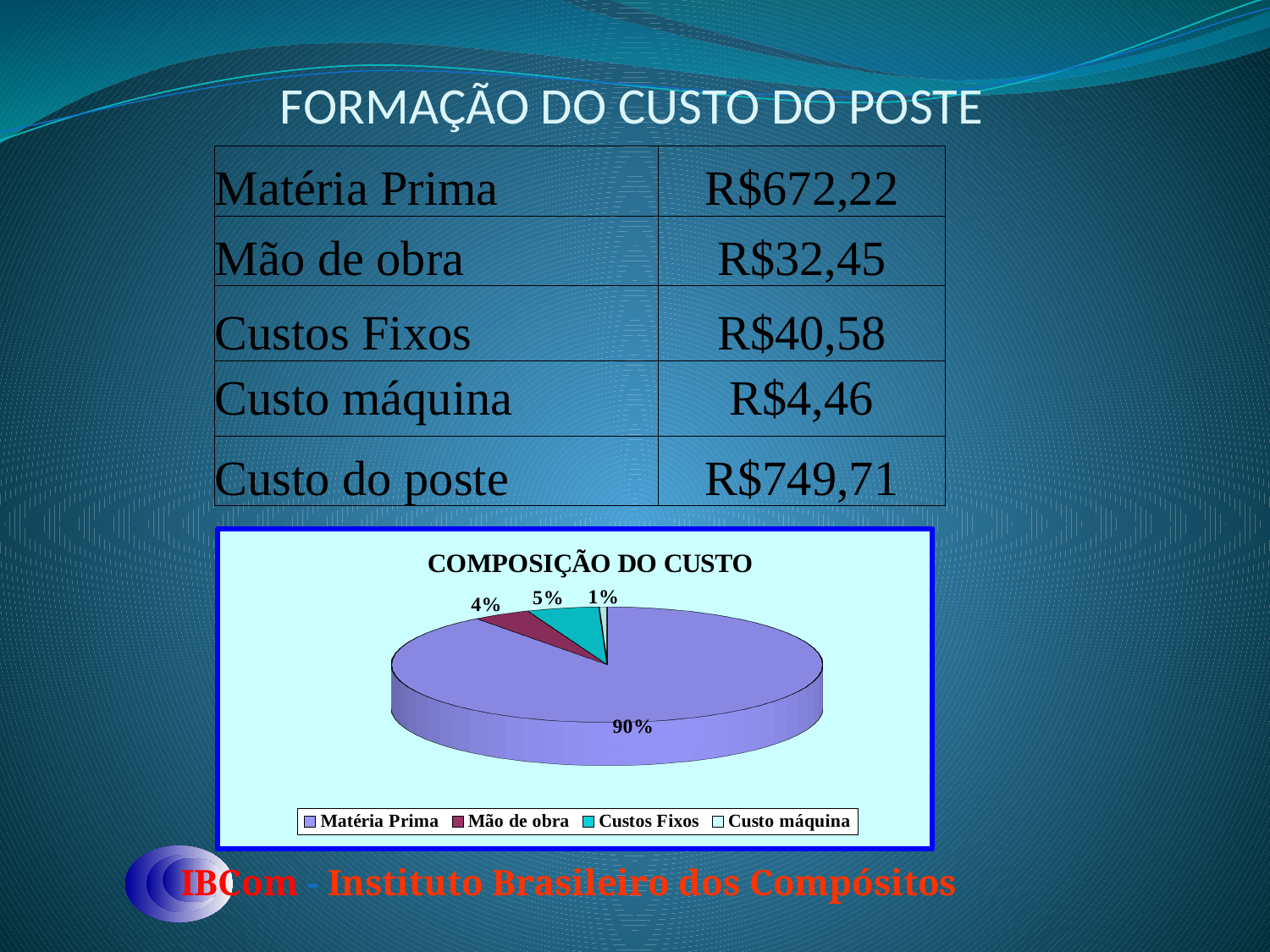
Which category has the largest slice of the pie? Matéria Prima Which is larger, the slice for Custos Fixos or the slice for Mão de obra? Custos Fixos What kind of chart is shown on the slide? pie chart What share of the pie does Mão de obra represent? 4% What is the title of the chart? COMPOSIÇÃO DO CUSTO What share of the pie does Matéria Prima represent? 90% Which category has the smallest slice of the pie? Custo máquina What share of the pie does Custos Fixos represent? 5% How many categories does the pie chart show? 4 What is the difference in percentage points between the Matéria Prima slice and the Custos Fixos slice? 85 How many entries does the legend list? 4